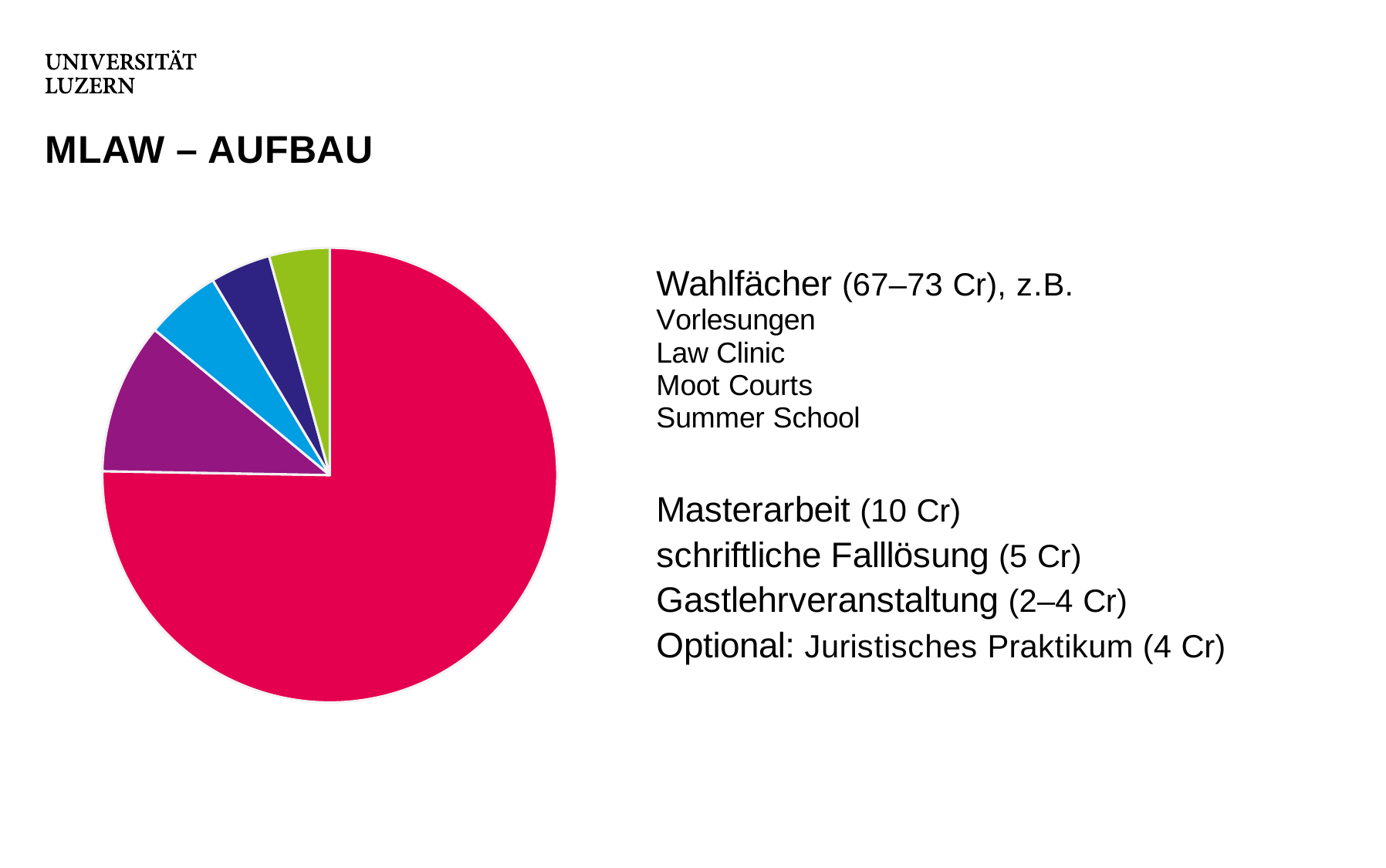
What kind of chart is shown on the slide? pie chart Which is larger in the pie chart, the purple slice or the light blue slice? the purple slice How many slices does the pie chart have? 5 What is the title of the slide containing the pie chart? MLAW – AUFBAU Which is larger in the pie chart, the red slice or the purple slice? the red slice Does the pie chart include a legend? No Which colour slice is the largest in the pie chart? red Does the red slice cover more or less than half of the pie? more